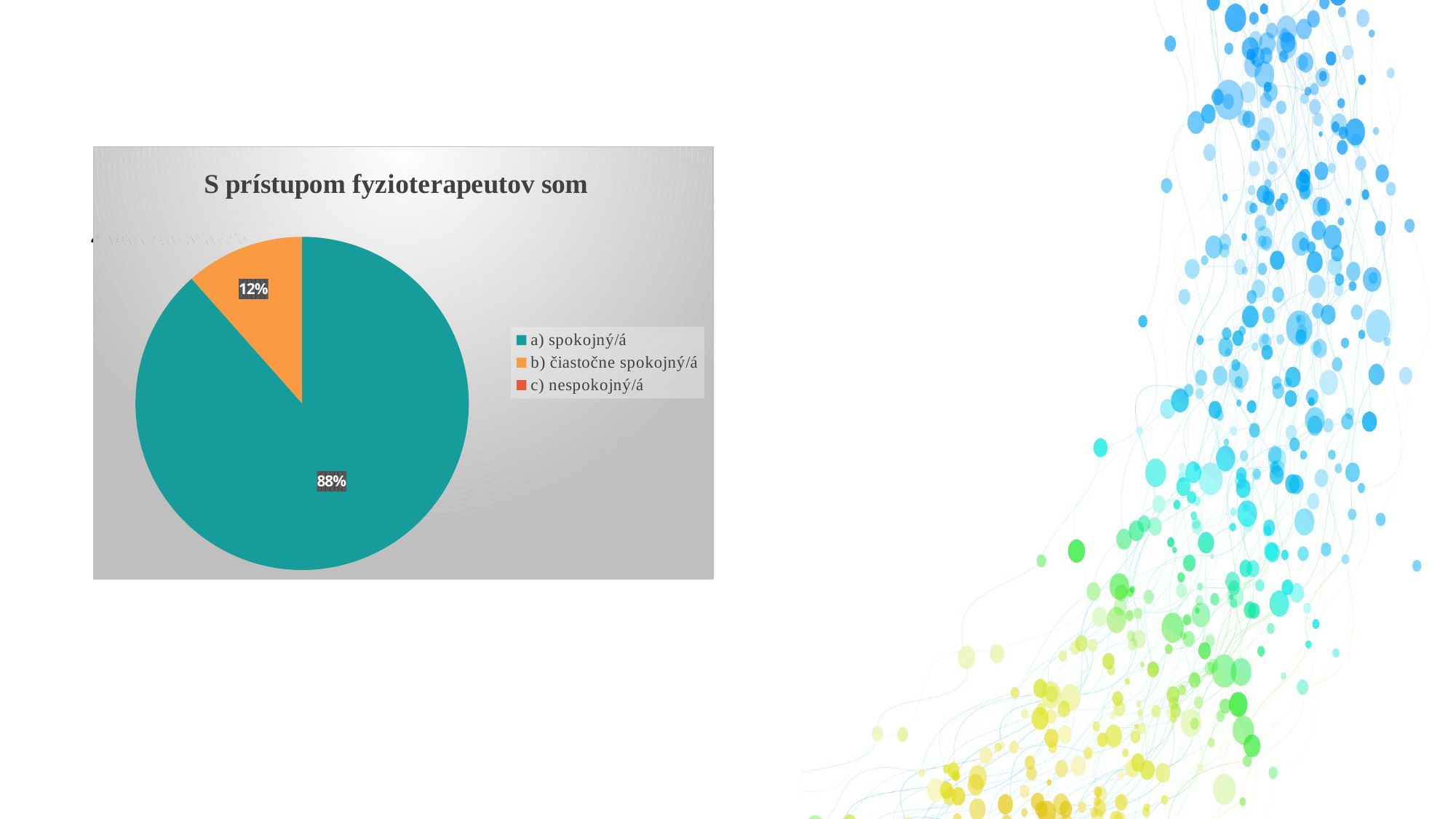
What share of the pie does "b) čiastočne spokojný/á" have? 12% What colour is the slice for "b) čiastočne spokojný/á"? orange Which is larger, the slice for "a) spokojný/á" or the slice for "b) čiastočne spokojný/á"? a) spokojný/á Is the share for "a) spokojný/á" greater or less than 50%? greater What is the difference in percentage points between the "a) spokojný/á" and "b) čiastočne spokojný/á" slices? 76 What share of the pie does "a) spokojný/á" have? 88% What kind of chart is shown on the slide? pie chart Which category has the largest slice of the pie? a) spokojný/á How many entries does the legend list? 3 What is the title of the chart? S prístupom fyzioterapeutov som